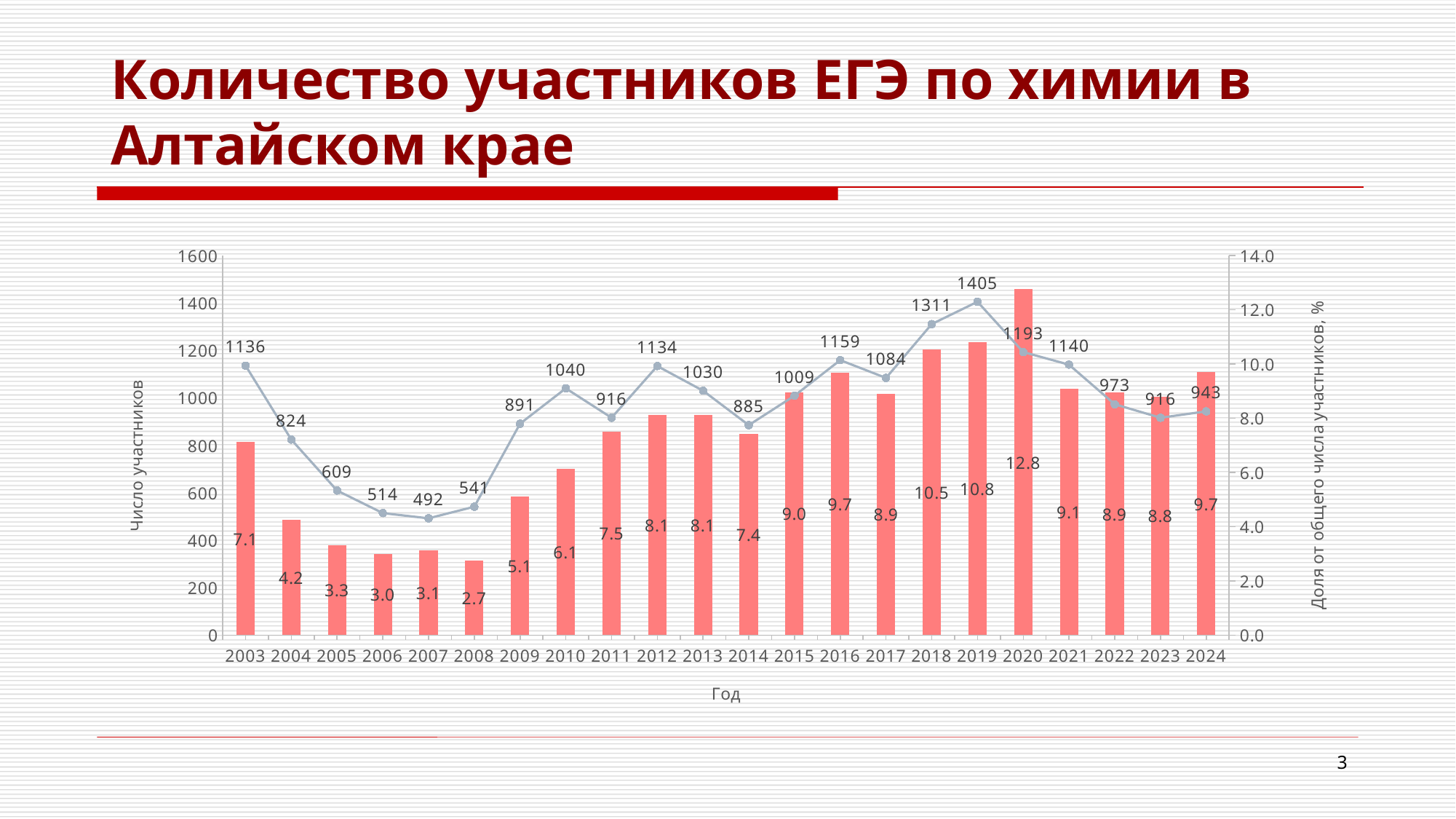
In which year is the number of participants (line) lowest? 2007 What is the difference between the number of participants in 2019 and in 2020? 212 What is the share value shown for 2024? 9.7 What is the number of participants shown for 2008? 541 What kind of chart is shown on the slide? Combined bar and line chart What is the share of the total number of participants (bar value) for 2020? 12.8 What is the number of participants (line value) for 2019? 1405 In which year is the number of participants (line) highest? 2019 How many years are shown on the x axis? 22 What is the label of the left vertical axis? Число участников Which year has a larger number of participants, 2003 or 2012? 2003 In which year is the share of participants (bar) lowest? 2008